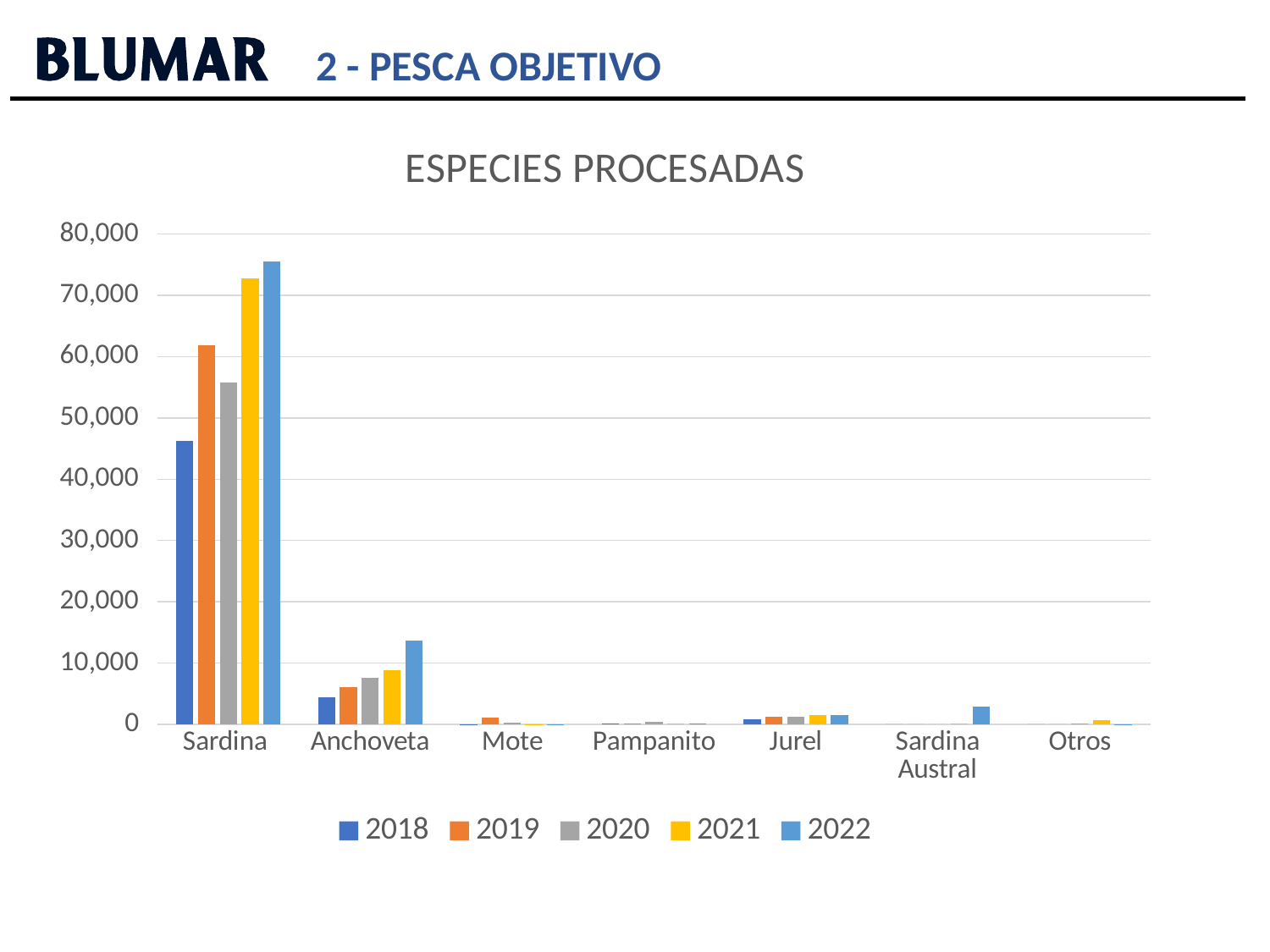
Is the value for Sardina in 2022 greater or less than 70,000? greater What kind of chart is shown on the slide? bar chart How many series does the legend list? 5 Is the value for Anchoveta in 2022 greater or less than 10,000? greater Is the value for Sardina in 2018 greater or less than 50,000? less Which species has the highest values across all years? Sardina What is the title of the chart? ESPECIES PROCESADAS Which is larger for Sardina: the 2019 value or the 2020 value? 2019 Which year has the highest value for Sardina? 2022 How many species categories are shown on the x axis? 7 Do the values for Anchoveta rise or fall from 2018 to 2022? rise Which year has the lowest value for Sardina? 2018